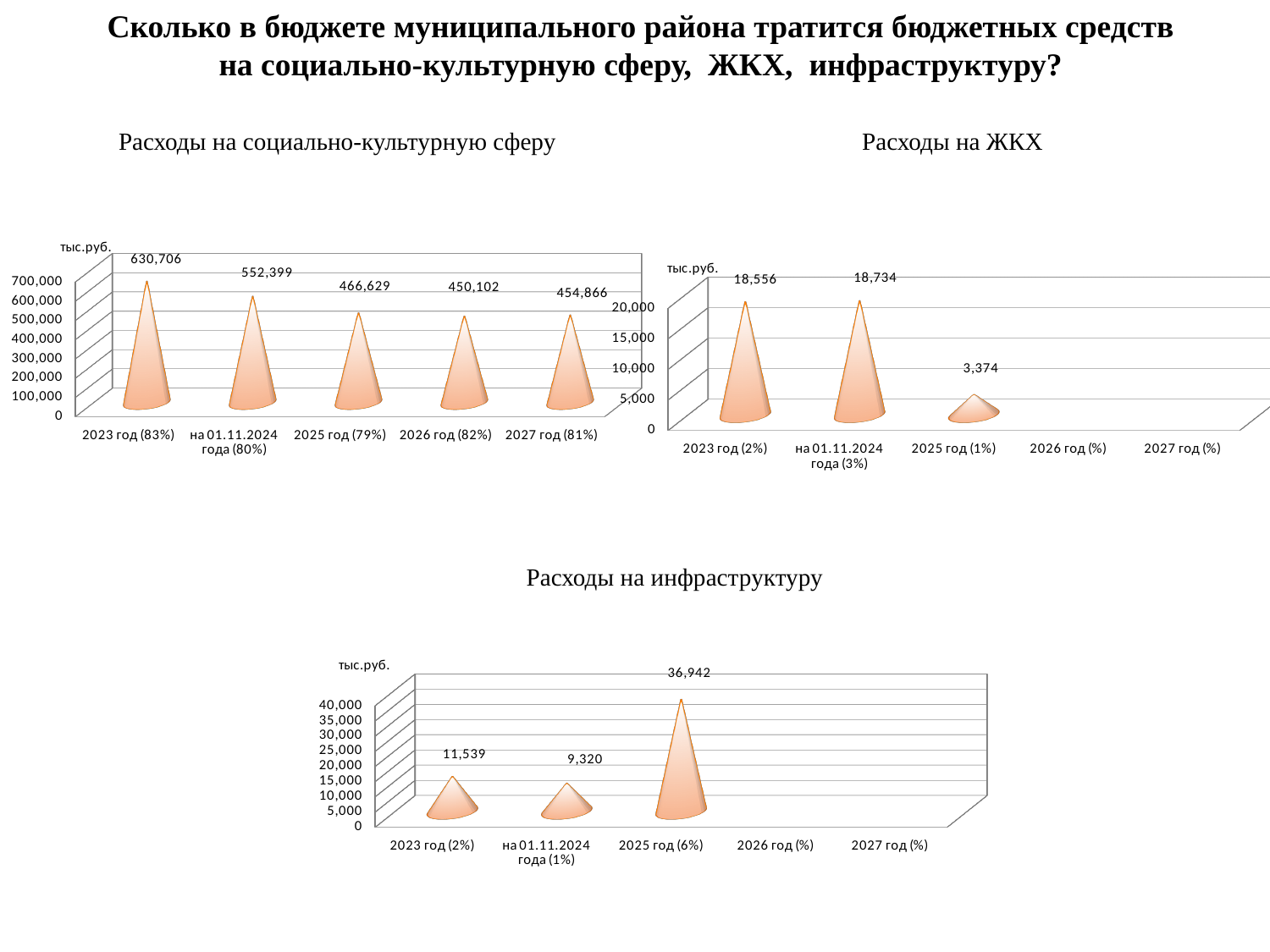
In the chart 'Расходы на социально-культурную сферу', what is the difference between the values for 2023 год (83%) and на 01.11.2024 года (80%)? 78,307 In the chart 'Расходы на ЖКХ', what is the difference between the values for на 01.11.2024 года (3%) and 2023 год (2%)? 178 In the chart 'Расходы на ЖКХ', which category has the highest value? на 01.11.2024 года (3%) In the chart 'Расходы на инфраструктуру', which is larger, the value for 2023 год (2%) or на 01.11.2024 года (1%)? 2023 год (2%) In the chart 'Расходы на социально-культурную сферу', how many categories are shown on the x axis? 5 In the chart 'Расходы на ЖКХ', what is the value for 2025 год (1%)? 3,374 What kind of chart is 'Расходы на инфраструктуру'? Bar chart In the chart 'Расходы на инфраструктуру', what is the difference between the values for 2025 год (6%) and 2023 год (2%)? 25,403 What unit is shown on the vertical axis of the chart 'Расходы на ЖКХ'? тыс.руб. In the chart 'Расходы на инфраструктуру', what is the value for 2025 год (6%)? 36,942 In the chart 'Расходы на социально-культурную сферу', what is the value for 2023 год (83%)? 630,706 In the chart 'Расходы на социально-культурную сферу', which category has the lowest value? 2026 год (82%)